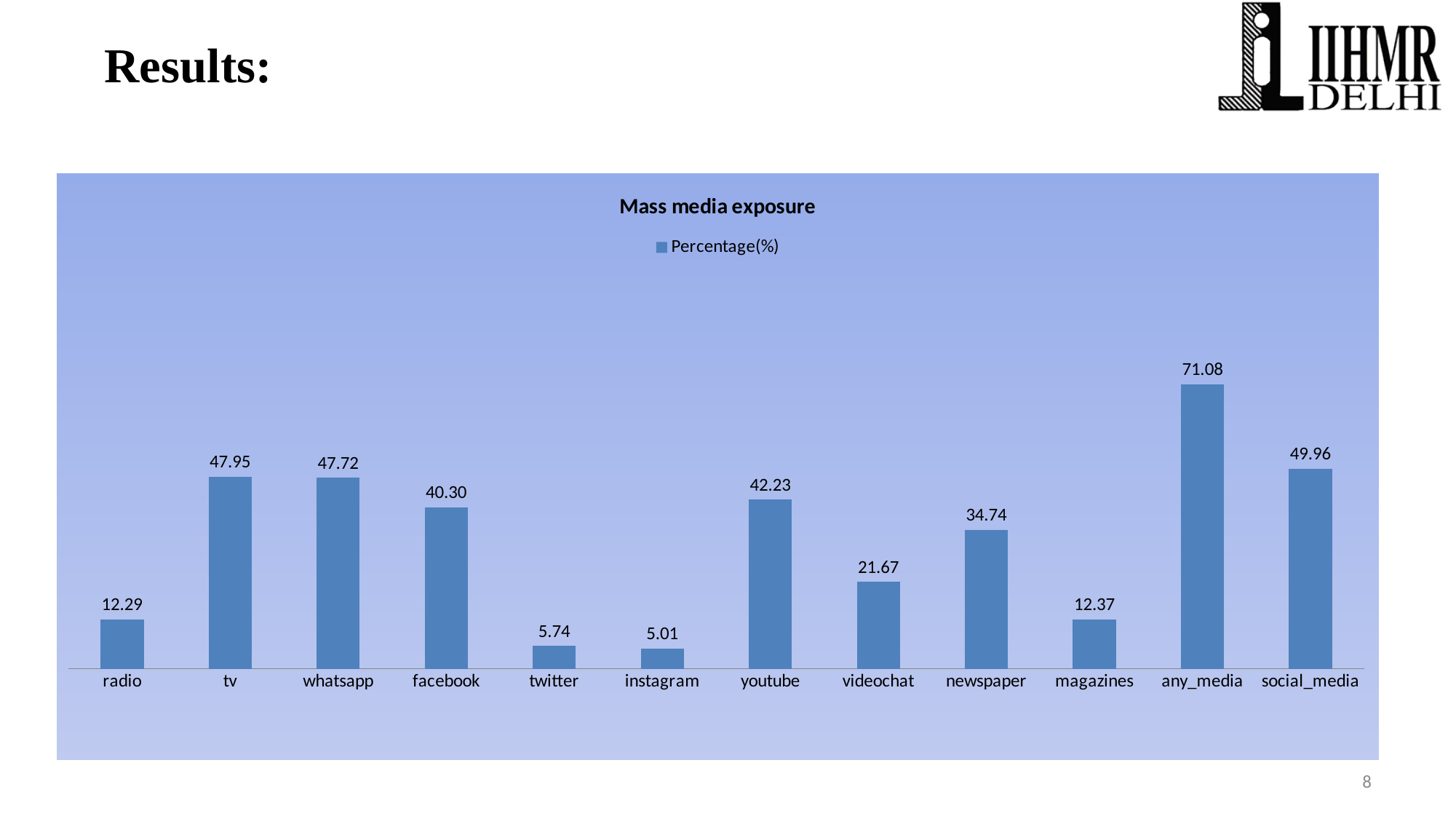
What is the value for newspaper in the Mass media exposure chart? 34.74 What is the difference between the values for any_media and social_media? 21.12 Which is larger, the value for facebook or the value for youtube? youtube Which category has the lowest value in the Mass media exposure chart? instagram What series name does the legend of the Mass media exposure chart show? Percentage(%) How many categories are shown in the Mass media exposure chart? 12 What is the value for youtube in the Mass media exposure chart? 42.23 What is the value for videochat in the Mass media exposure chart? 21.67 Which category has the highest value in the Mass media exposure chart? any_media What kind of chart is shown on the slide? bar chart Which is larger, the value for magazines or the value for videochat? videochat What is the difference between the values for tv and radio? 35.66